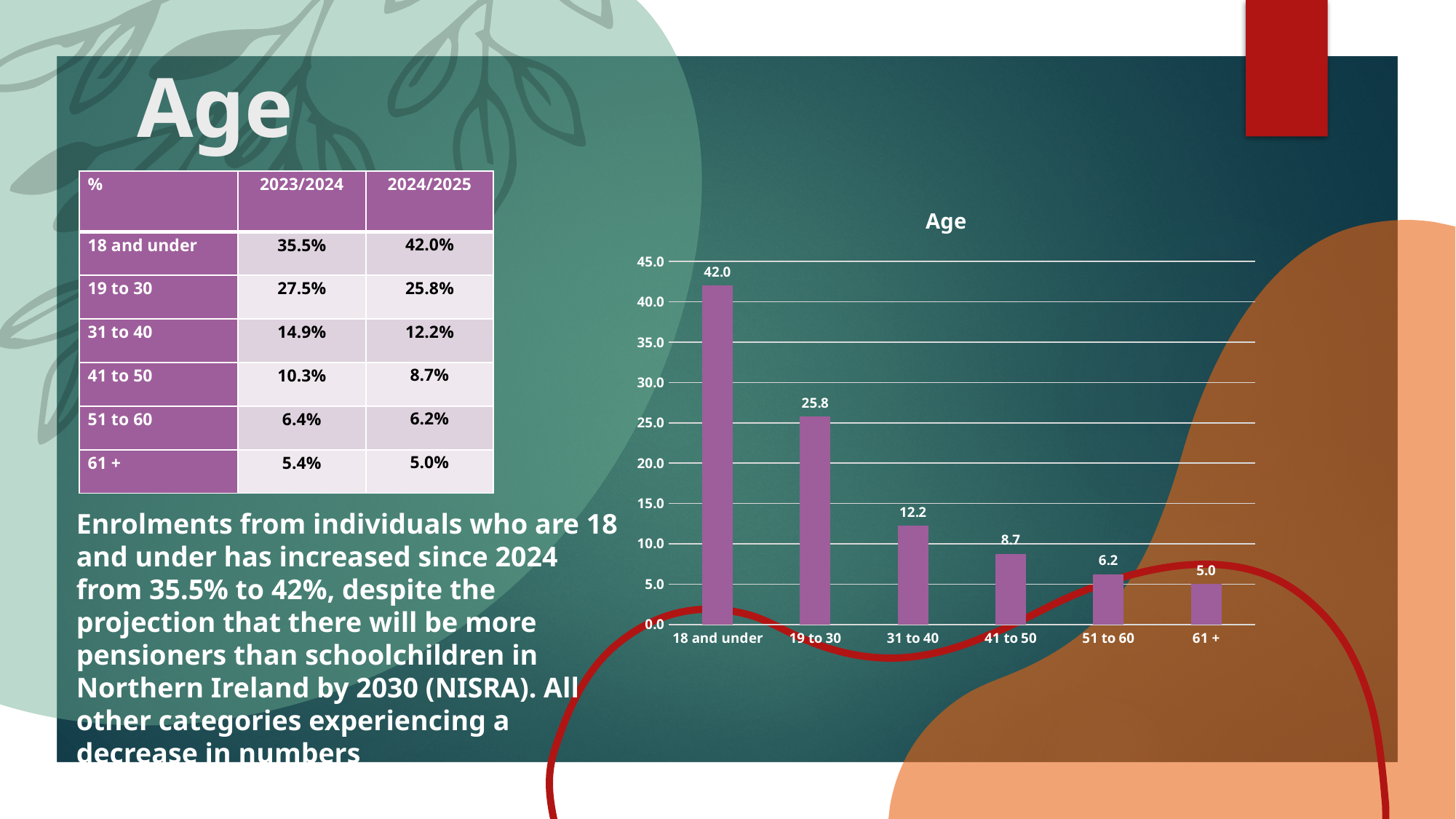
What is the difference between the values for 18 and under and 19 to 30 in the Age chart? 16.2 Which category has the highest value in the Age chart? 18 and under Do the values in the Age chart rise or fall from left to right along the x axis? fall What is the value for the 51 to 60 category in the Age chart? 6.2 Which is larger in the Age chart, the value for 19 to 30 or the value for 31 to 40? 19 to 30 What kind of chart is shown on the slide? bar chart Which category has the lowest value in the Age chart? 61 + What is the value for the 31 to 40 category in the Age chart? 12.2 What is the value for the 18 and under category in the Age chart? 42.0 How many categories are shown on the x axis of the Age chart? 6 Is the value for 41 to 50 in the Age chart greater or less than 10.0? less What is the difference between the values for 41 to 50 and 61 + in the Age chart? 3.7